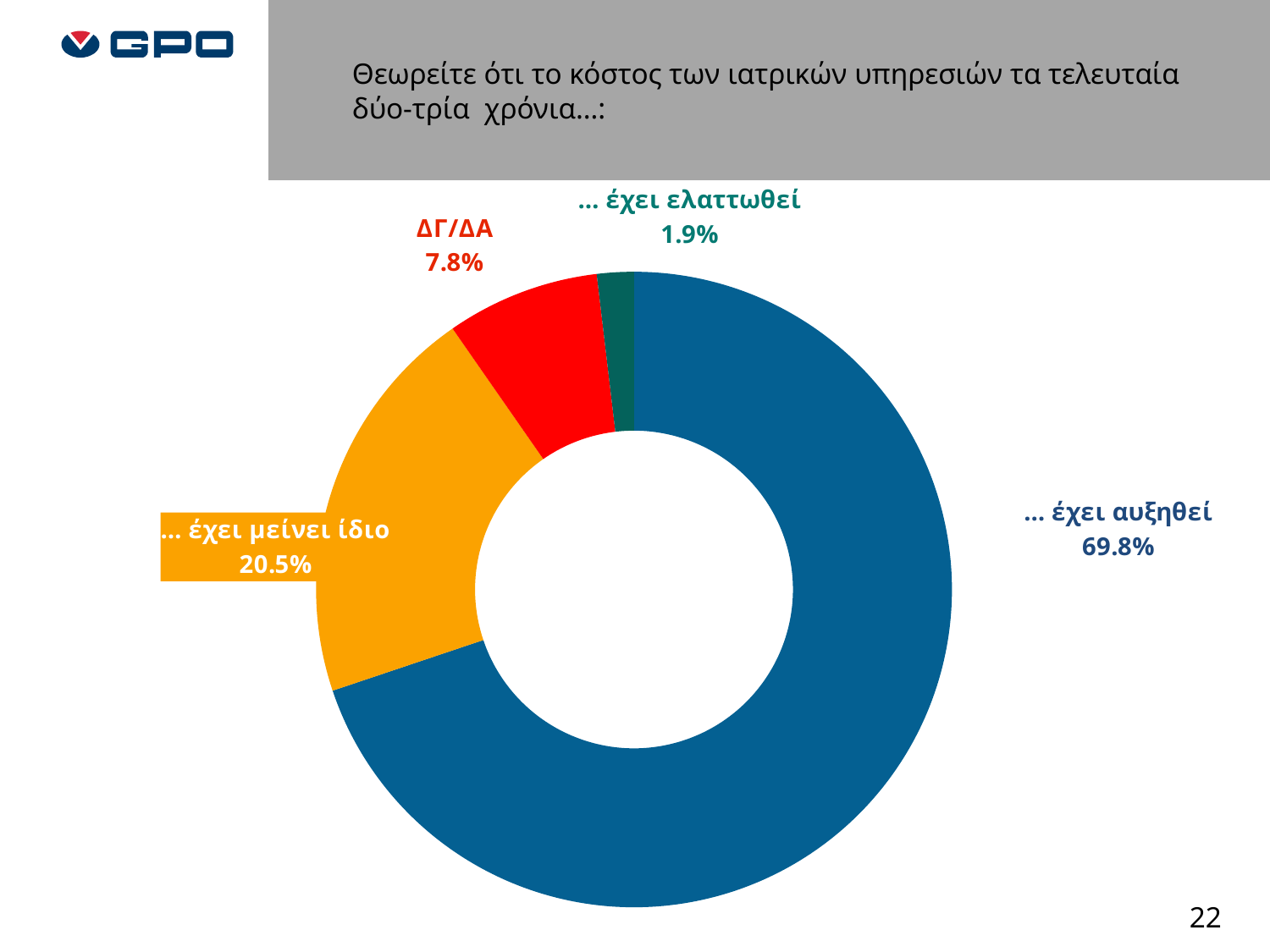
What kind of chart is shown on the slide? Doughnut (pie) chart Which is larger: the share for "ΔΓ/ΔΑ" or the share for "… έχει ελαττωθεί"? ΔΓ/ΔΑ What is the difference in percentage points between "ΔΓ/ΔΑ" and "… έχει ελαττωθεί"? 5.9 percentage points Which response has the smallest share of the chart? … έχει ελαττωθεί What percentage of respondents answered "… έχει ελαττωθεί"? 1.9% What percentage of respondents answered "… έχει μείνει ίδιο"? 20.5% What colour is the slice for "… έχει μείνει ίδιο"? Orange How many categories (slices) does the chart have? 4 What is the difference in percentage points between "… έχει αυξηθεί" and "… έχει μείνει ίδιο"? 49.3 percentage points What percentage is shown for "ΔΓ/ΔΑ"? 7.8% Which response has the largest share of the chart? … έχει αυξηθεί What percentage of respondents answered "… έχει αυξηθεί"? 69.8%